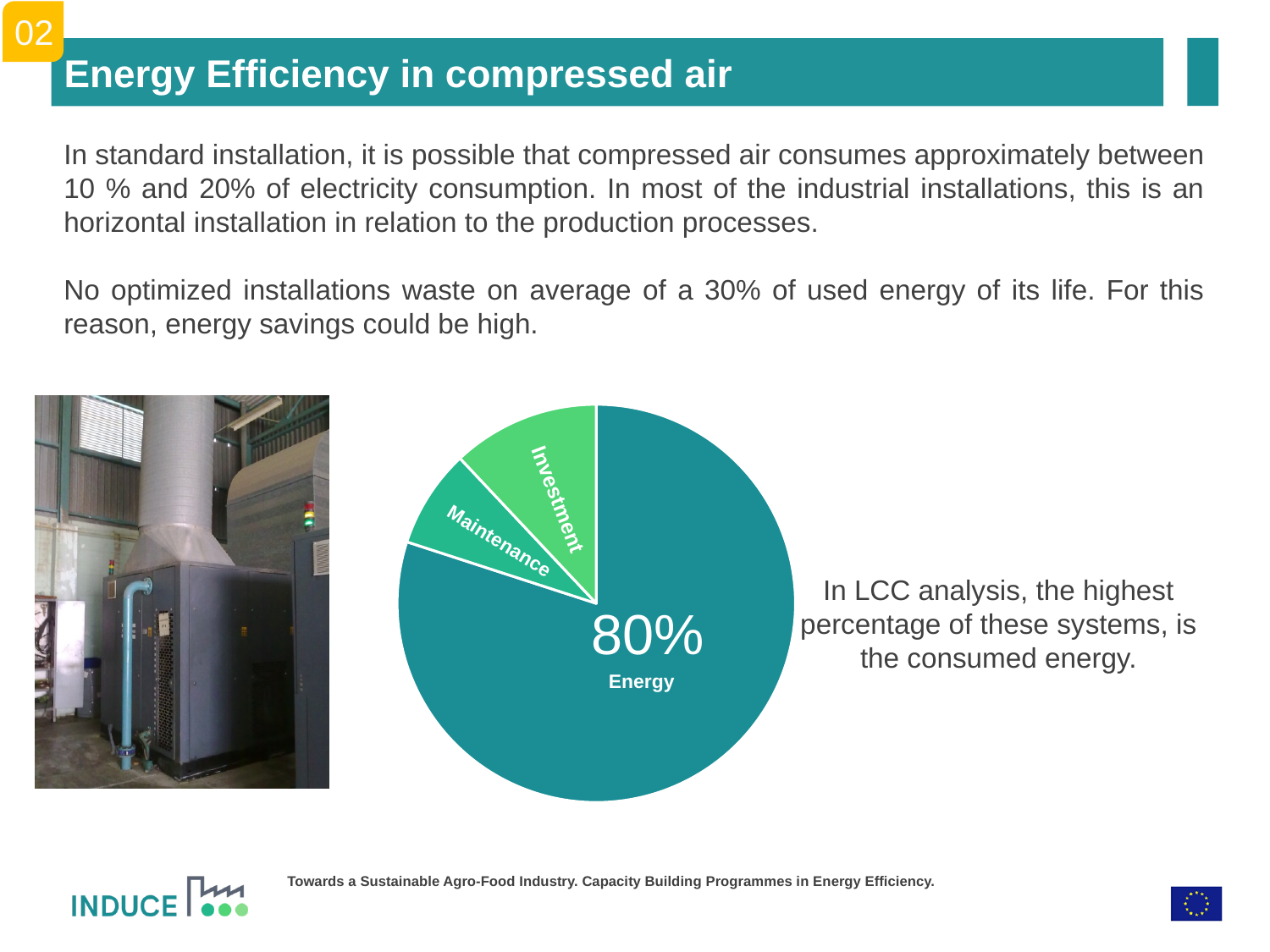
What colour is the Energy slice of the pie chart? Teal What share of the pie does the Energy slice represent? 80% Which is larger in the pie chart, Energy or Investment? Energy How many slices does the pie chart have? 3 What are the labels of the three slices in the pie chart? Energy, Maintenance, Investment What percentage is shown for the Energy slice of the pie chart? 80% What kind of chart is shown on the slide? Pie chart Which slice of the pie chart is the largest? Energy Which is larger in the pie chart, Energy or Maintenance? Energy